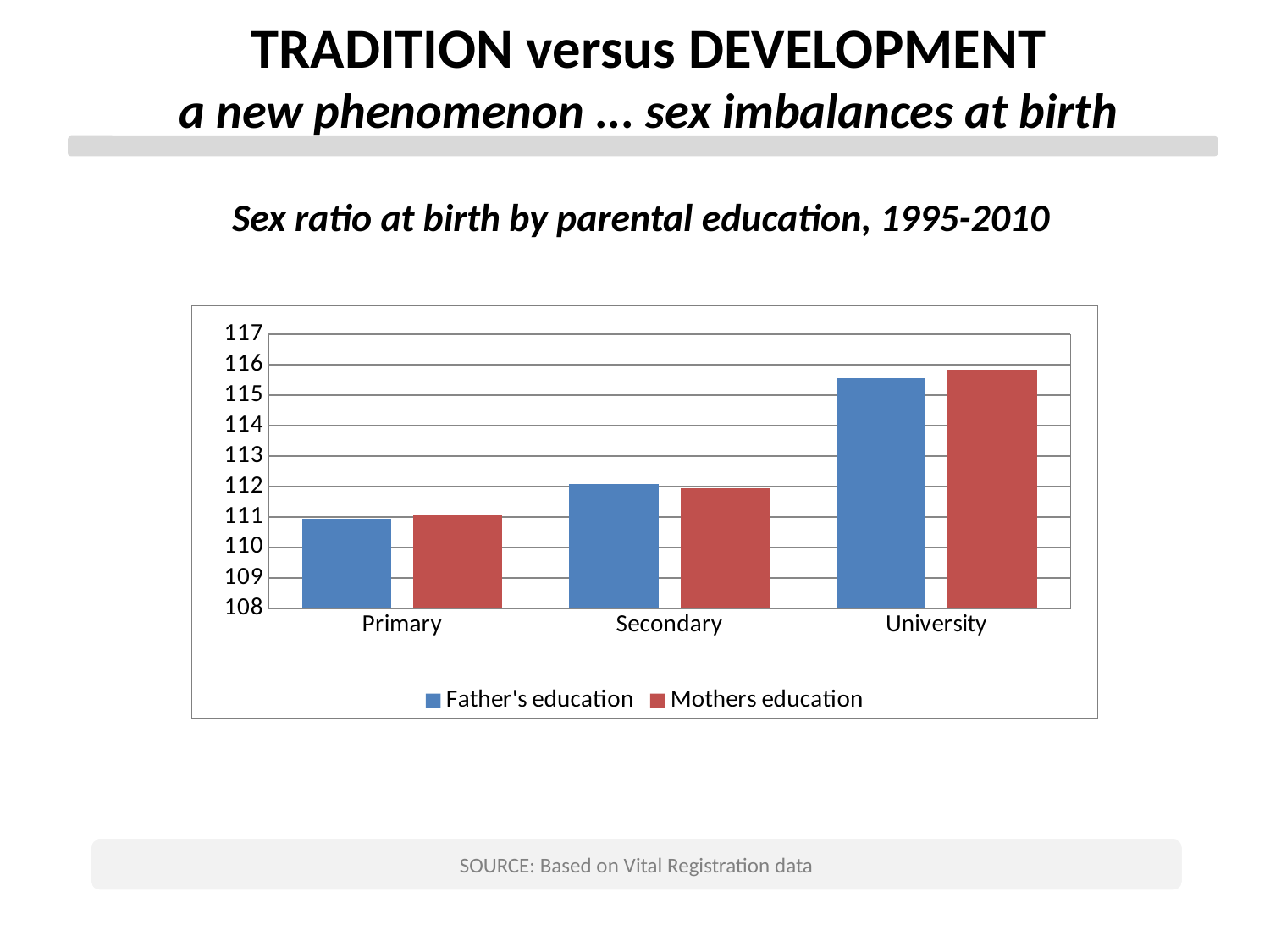
Is the value for Father's education at Secondary greater or less than 111? greater Do the Mothers education values rise or fall from Primary to University? rise Which is larger: Father's education at University or Father's education at Primary? Father's education at University How many series does the legend list? 2 Which education category has the lowest sex ratio at birth for Mothers education? Primary What is the title of the chart? Sex ratio at birth by parental education, 1995-2010 What kind of chart is shown on the slide? bar chart How many education categories are shown on the x axis? 3 Is the value for Father's education at University greater or less than 116? less Is the value for Father's education at Primary greater or less than 112? less Which education category has the highest sex ratio at birth for Father's education? University